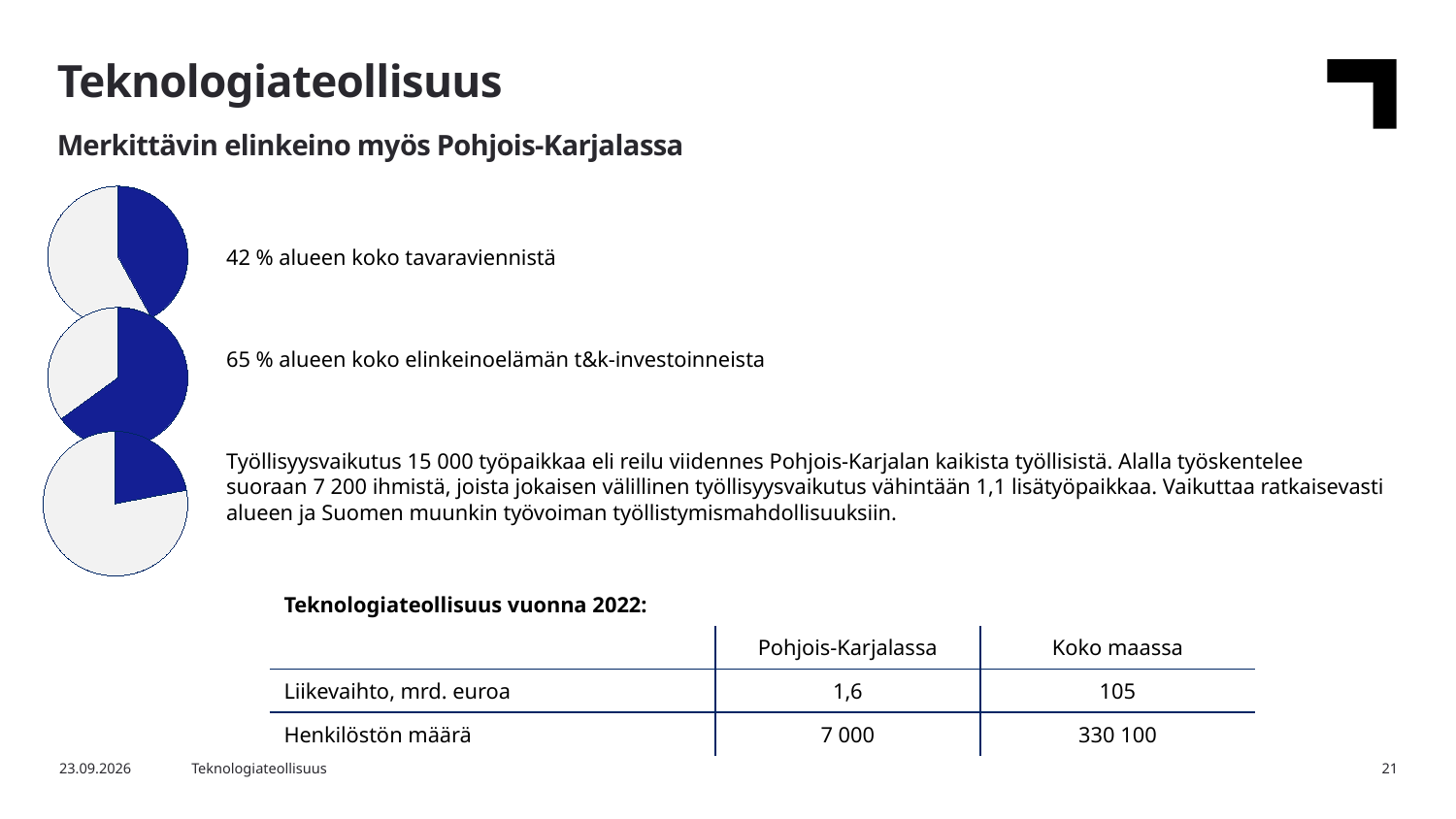
According to the text next to the top pie chart, what share of the region's total goods exports does the technology industry account for? 42 % What kind of charts are shown on the left side of the slide? Pie charts According to the text next to the middle pie chart, what share of the region's business R&D investments does the technology industry account for? 65 % Is the highlighted slice larger in the top pie chart (tavaravienti) or in the middle pie chart (t&k-investoinnit)? Middle pie chart (t&k-investoinnit) How many pie charts are on the slide? 3 Which pie chart has the smallest highlighted (blue) slice: the top, middle or bottom one? Bottom Does the highlighted slice in the middle pie chart cover more or less than half of the pie? More Which pie chart has the largest highlighted (blue) slice: the top, middle or bottom one? Middle What is the difference in percentage points between the share shown for the middle pie chart (65 %) and the top pie chart (42 %)? 23 percentage points What colour is used for the highlighted slice in each pie chart? Dark blue